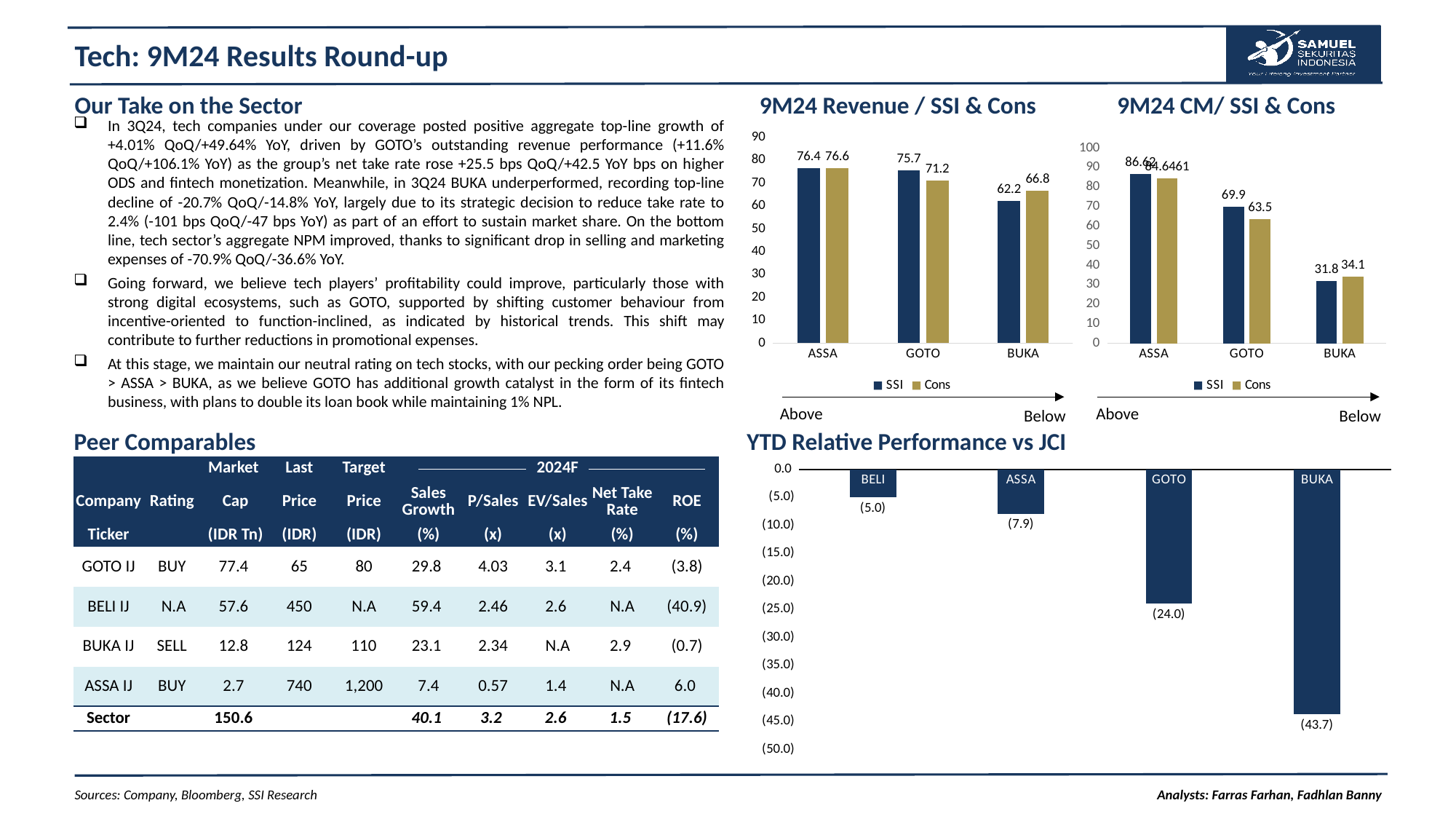
In the 9M24 Revenue / SSI & Cons chart, what is the difference between the SSI and Cons values for GOTO? 4.5 In the 9M24 CM/ SSI & Cons chart, how many companies are shown on the x axis? 3 In the 9M24 Revenue / SSI & Cons chart, what is the SSI value for GOTO? 75.7 In the 9M24 CM/ SSI & Cons chart, what is the Cons value for BUKA? 34.1 What kind of chart is the YTD Relative Performance vs JCI chart? Bar chart In the YTD Relative Performance vs JCI chart, what is the value for GOTO? (24.0) In the 9M24 CM/ SSI & Cons chart, what is the SSI value for GOTO? 69.9 In the YTD Relative Performance vs JCI chart, which company has the lowest value? BUKA In the 9M24 Revenue / SSI & Cons chart, how many series does the legend list? 2 In the 9M24 Revenue / SSI & Cons chart, which company has the lowest SSI value? BUKA In the 9M24 CM/ SSI & Cons chart, is the SSI value for GOTO larger or the Cons value for GOTO? SSI In the 9M24 Revenue / SSI & Cons chart, what is the Cons value for BUKA? 66.8